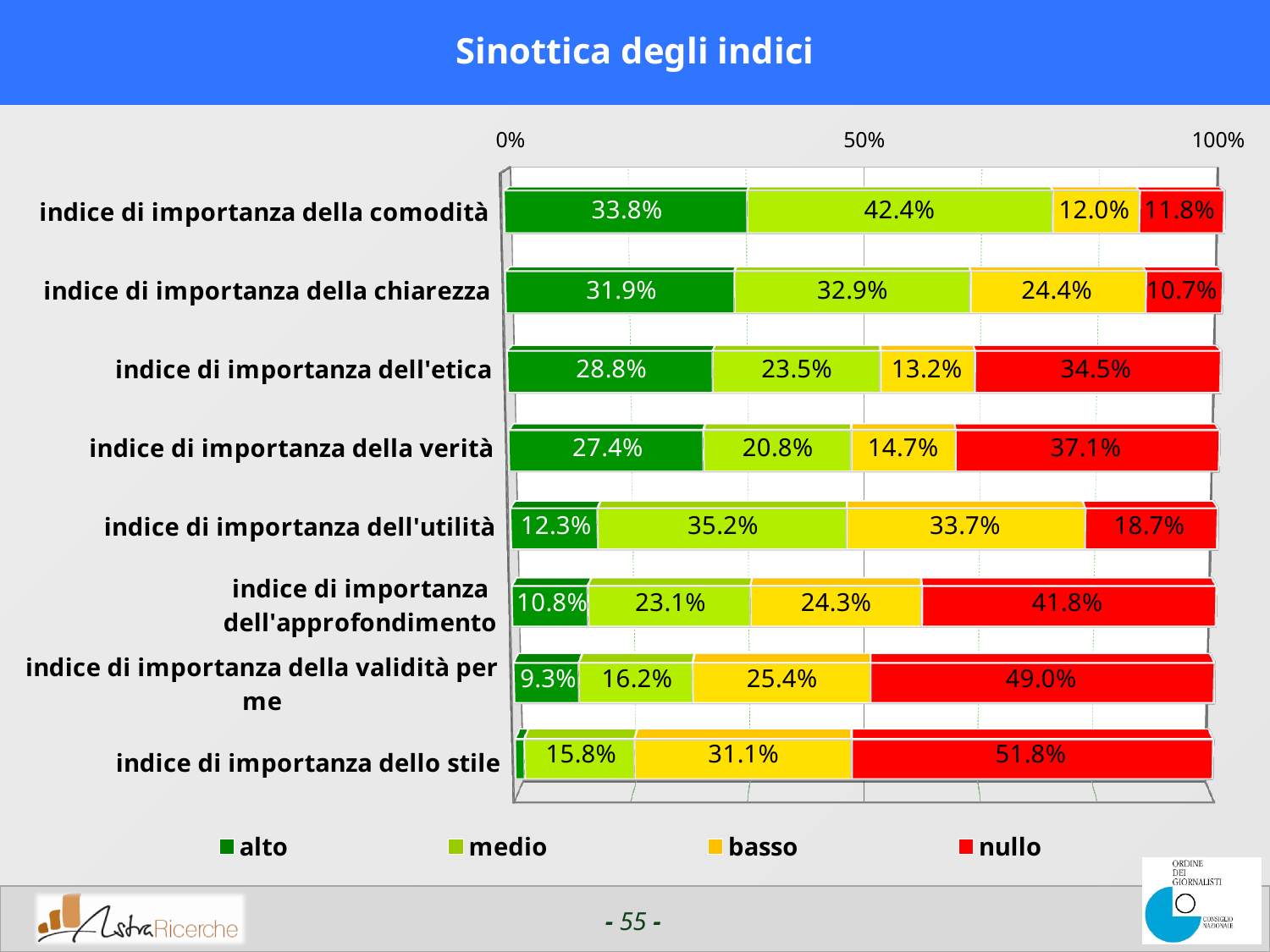
How many series does the legend list? 4 What is the 'medio' value for 'indice di importanza della chiarezza'? 32.9% How many categories (indices) are plotted on the chart? 8 What is the 'nullo' value for 'indice di importanza dello stile'? 51.8% What is the 'basso' value for 'indice di importanza dell'utilità'? 33.7% Which legend entry is shown in red? nullo Which is larger: the 'alto' value for 'indice di importanza della verità' or the 'alto' value for 'indice di importanza dell'utilità'? indice di importanza della verità Which index has the lowest 'nullo' value? indice di importanza della chiarezza What kind of chart is shown on the slide? stacked bar chart What is the difference between the 'nullo' values for 'indice di importanza della validità per me' and 'indice di importanza dell'etica'? 14.5% Which index has the highest 'nullo' value? indice di importanza dello stile What is the 'alto' value for 'indice di importanza della comodità'? 33.8%